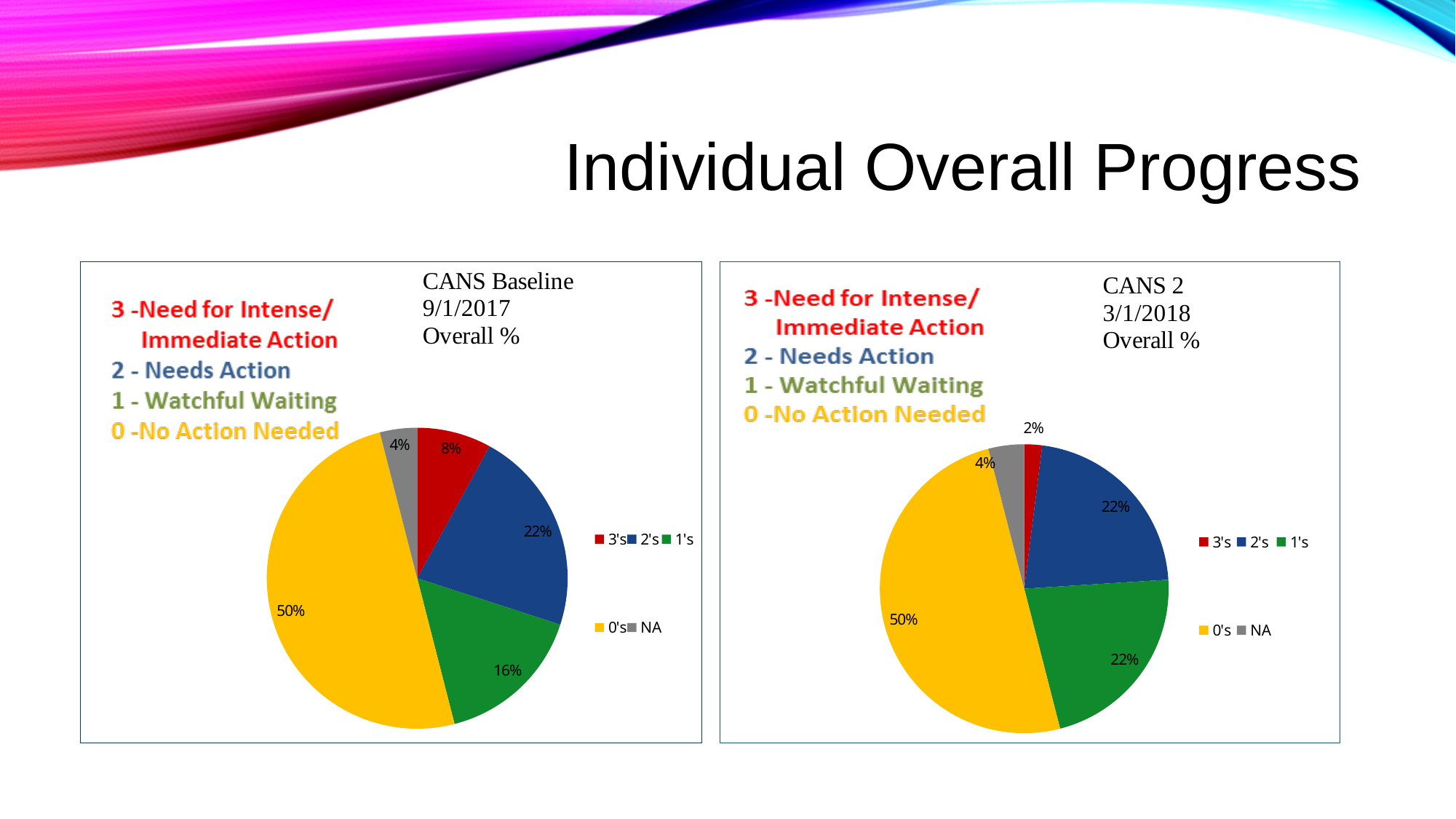
In the CANS 2 chart on the right, what percentage is shown for the 3's slice? 2% In the CANS Baseline chart on the left, what percentage is shown for the 1's slice? 16% In the CANS 2 chart on the right, which category has the smallest slice? 3's What is the difference between the 3's percentage in the CANS Baseline chart and the 3's percentage in the CANS 2 chart? 6% In the CANS Baseline chart on the left, which is larger, the 2's slice or the 1's slice? 2's In the CANS 2 chart on the right, what percentage is shown for the 1's slice? 22% In the CANS Baseline chart on the left, what share of the pie does the 0's slice represent? 50% In the CANS Baseline chart on the left, which category has the largest slice? 0's What date is shown in the title of the chart on the right? 3/1/2018 How many categories does the legend of the CANS 2 chart on the right list? 5 In the CANS Baseline chart on the left, what percentage is shown for the 3's slice? 8% What kind of chart is the CANS Baseline chart on the left? Pie chart